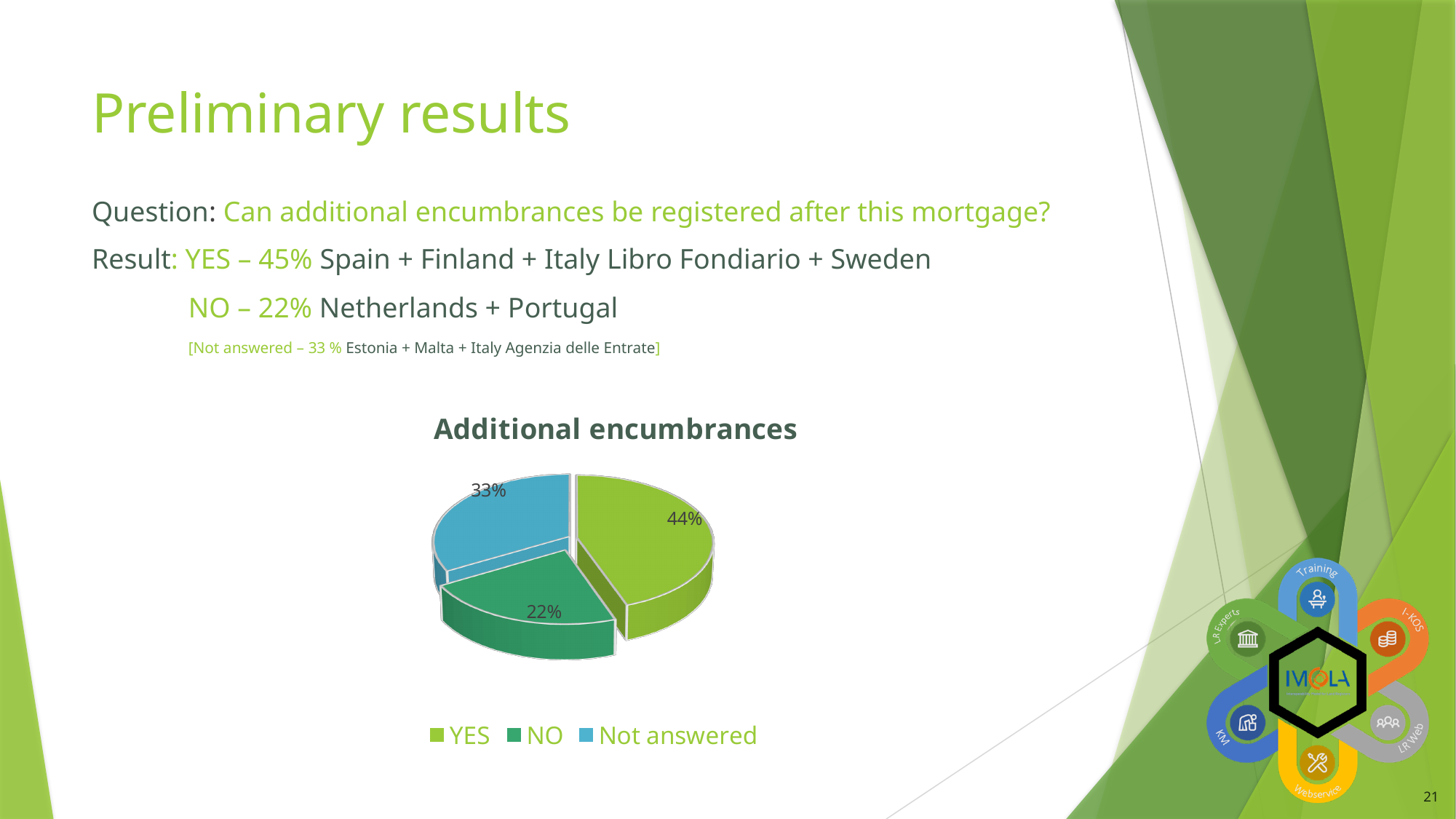
Which slice is larger, Not answered or NO? Not answered What percentage does the YES slice show in the chart? 44% How many entries does the chart legend list? 3 What type of chart is shown on the slide? Pie chart What is the title of the chart? Additional encumbrances Which category has the largest slice in the chart? YES Which category has the smallest slice in the chart? NO What is the difference in percentage points between the YES slice and the NO slice? 22 What percentage does the Not answered slice show in the chart? 33% What percentage does the NO slice show in the chart? 22% What colour is the Not answered slice in the chart? Blue How many slices does the pie chart have? 3